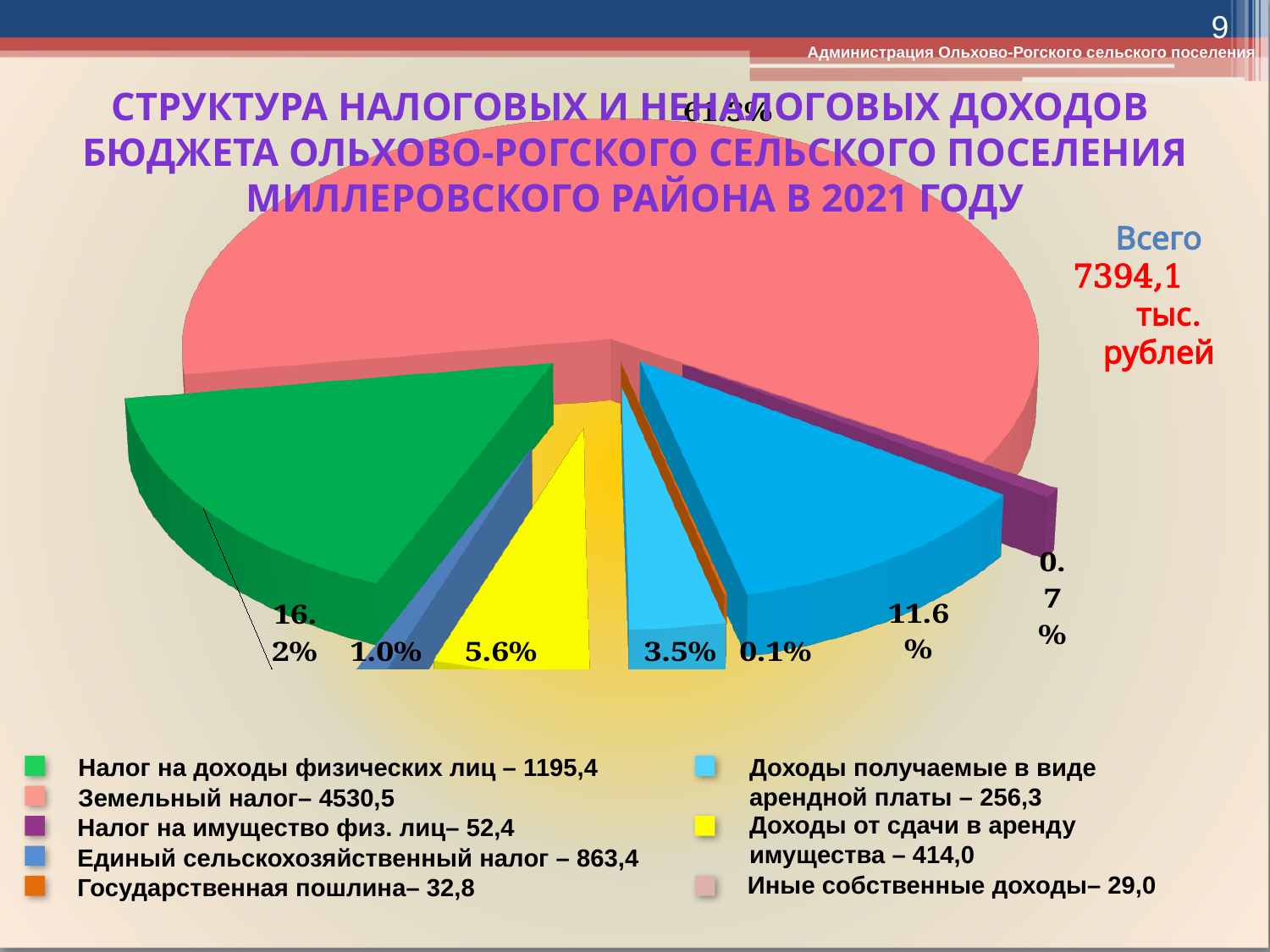
What is the value for Земельный налог? 4530,5 Which revenue category has the smallest value? Иные собственные доходы Which revenue category has the largest value? Земельный налог What share of the pie does the green slice (Налог на доходы физических лиц) represent? 16.2% Which is larger: Доходы получаемые в виде арендной платы or Доходы от сдачи в аренду имущества? Доходы от сдачи в аренду имущества What is the value for Налог на доходы физических лиц? 1195,4 What is the difference between Налог на доходы физических лиц and Единый сельскохозяйственный налог? 332,0 What kind of chart is shown on the slide? pie chart What is the value for Доходы от сдачи в аренду имущества? 414,0 How many revenue categories does the legend list? 8 What is the value for Единый сельскохозяйственный налог? 863,4 What is the total amount of tax and non-tax revenues shown on the slide (Всего)? 7394,1 тыс. рублей